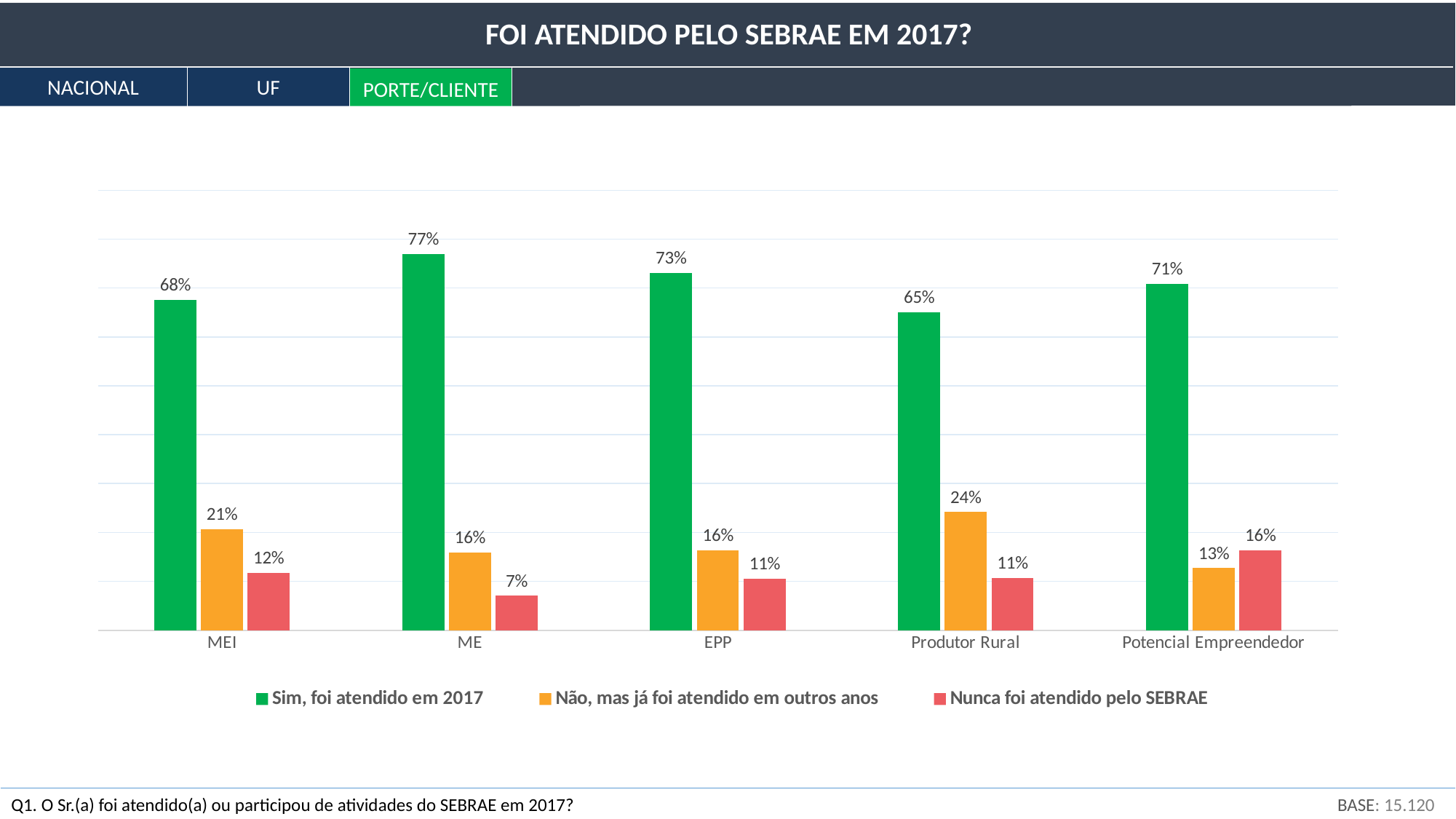
What is the value for Produtor Rural in the 'Não, mas já foi atendido em outros anos' series? 24% How many series does the legend list? 3 What is the difference between the 'Sim, foi atendido em 2017' values for ME and Produtor Rural? 12% What kind of chart is shown on the slide? Bar chart Which category has the lowest value in the 'Nunca foi atendido pelo SEBRAE' series? ME What is the title of the chart? FOI ATENDIDO PELO SEBRAE EM 2017? What is the value for Potencial Empreendedor in the 'Nunca foi atendido pelo SEBRAE' series? 16% How many categories are shown on the x axis? 5 Which colour represents the 'Nunca foi atendido pelo SEBRAE' series? Red Which category has the highest value in the 'Sim, foi atendido em 2017' series? ME What is the value for ME in the 'Sim, foi atendido em 2017' series? 77% Which is larger: the 'Não, mas já foi atendido em outros anos' value for MEI or for EPP? MEI